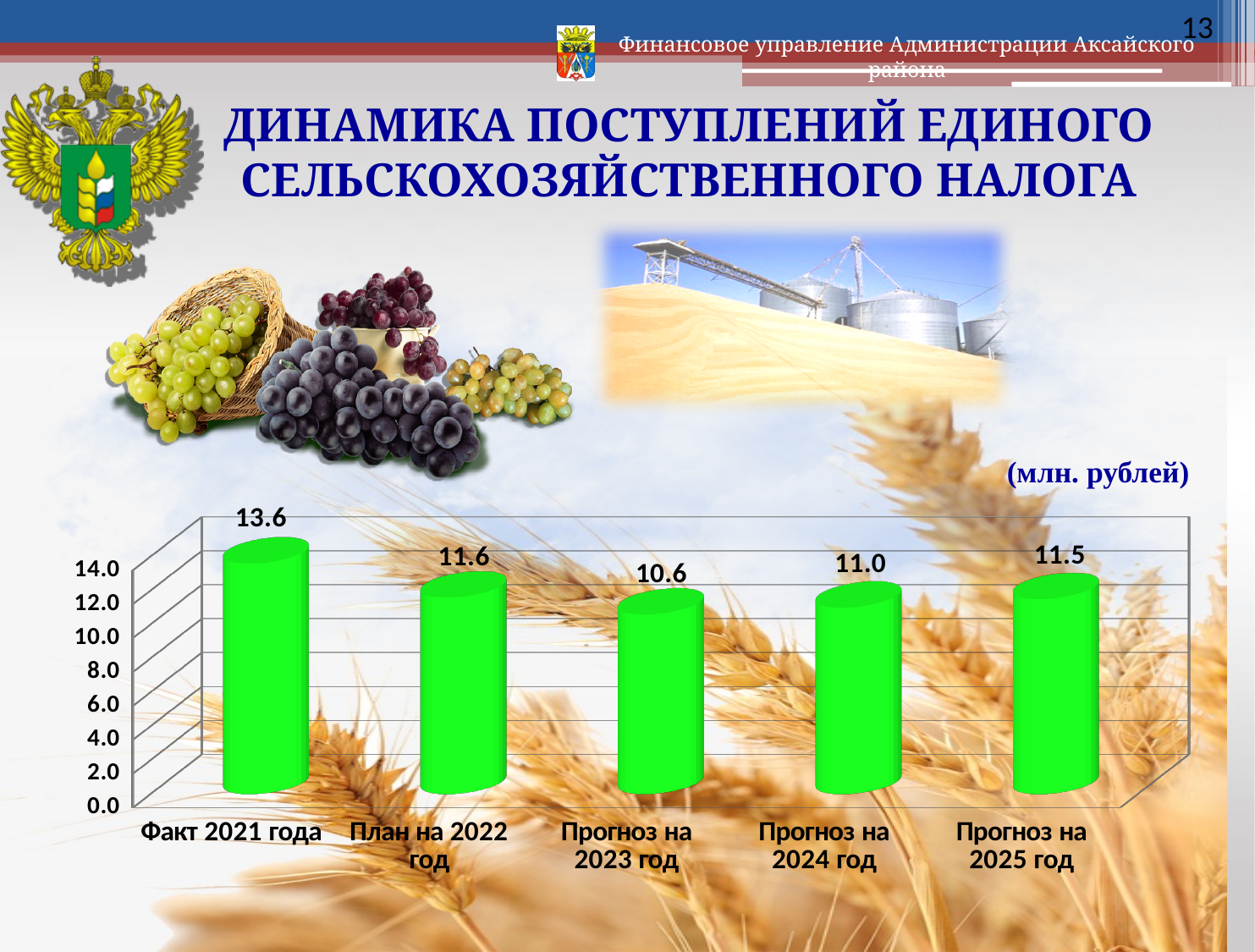
Does the value rise or fall from Факт 2021 года to Прогноз на 2023 год? Fall What is the value for Прогноз на 2025 год? 11.5 What is the value for План на 2022 год? 11.6 What is the value for Факт 2021 года? 13.6 Which category has the highest value? Факт 2021 года Which is larger, the value for Прогноз на 2024 год or Прогноз на 2025 год? Прогноз на 2025 год What kind of chart is shown on the slide? Bar chart Which category has the lowest value? Прогноз на 2023 год What is the value for Прогноз на 2023 год? 10.6 How many categories are shown on the chart? 5 What is the difference between the values for Факт 2021 года and План на 2022 год? 2.0 What unit is indicated for the chart values? млн. рублей